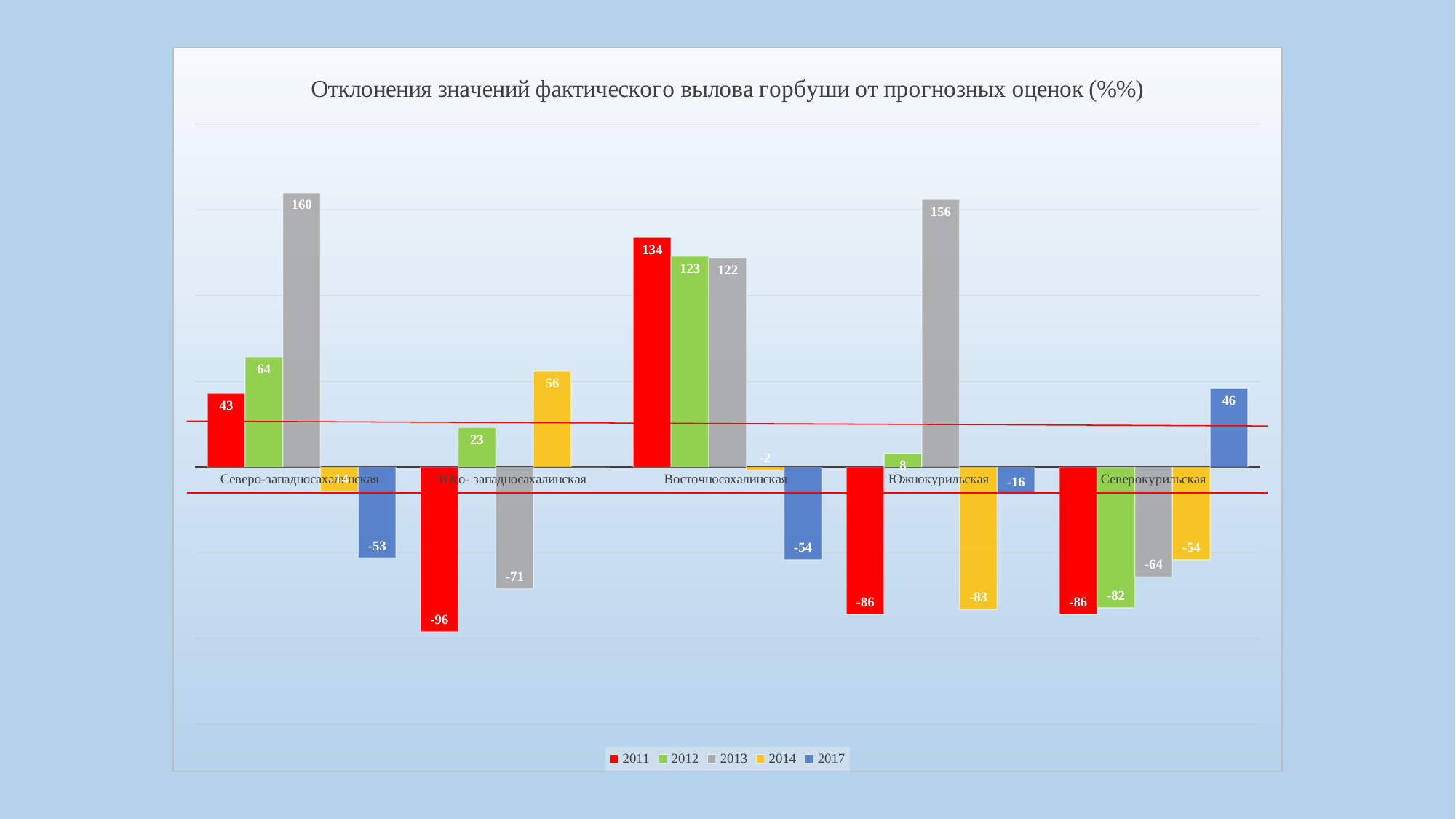
Which is larger: the 2012 value for Северо-западносахалинская or the 2014 value for Юго-западносахалинская? 2012 value for Северо-западносахалинская How many categories are shown on the x axis? 5 What is the value for 2011 in the Юго-западносахалинская category? -96 What is the value for 2013 in the Северо-западносахалинская category? 160 What is the difference between the 2011 and 2012 values for Восточносахалинская? 11 Which category has the highest value for the 2013 series? Северо-западносахалинская What is the title of the chart? Отклонения значений фактического вылова горбуши от прогнозных оценок (%%) Which category has the lowest value for the 2011 series? Юго-западносахалинская What is the value for 2014 in the Южнокурильская category? -83 How many series does the legend list? 5 What kind of chart is shown on the slide? Bar chart What is the value for 2017 in the Северокурильская category? 46